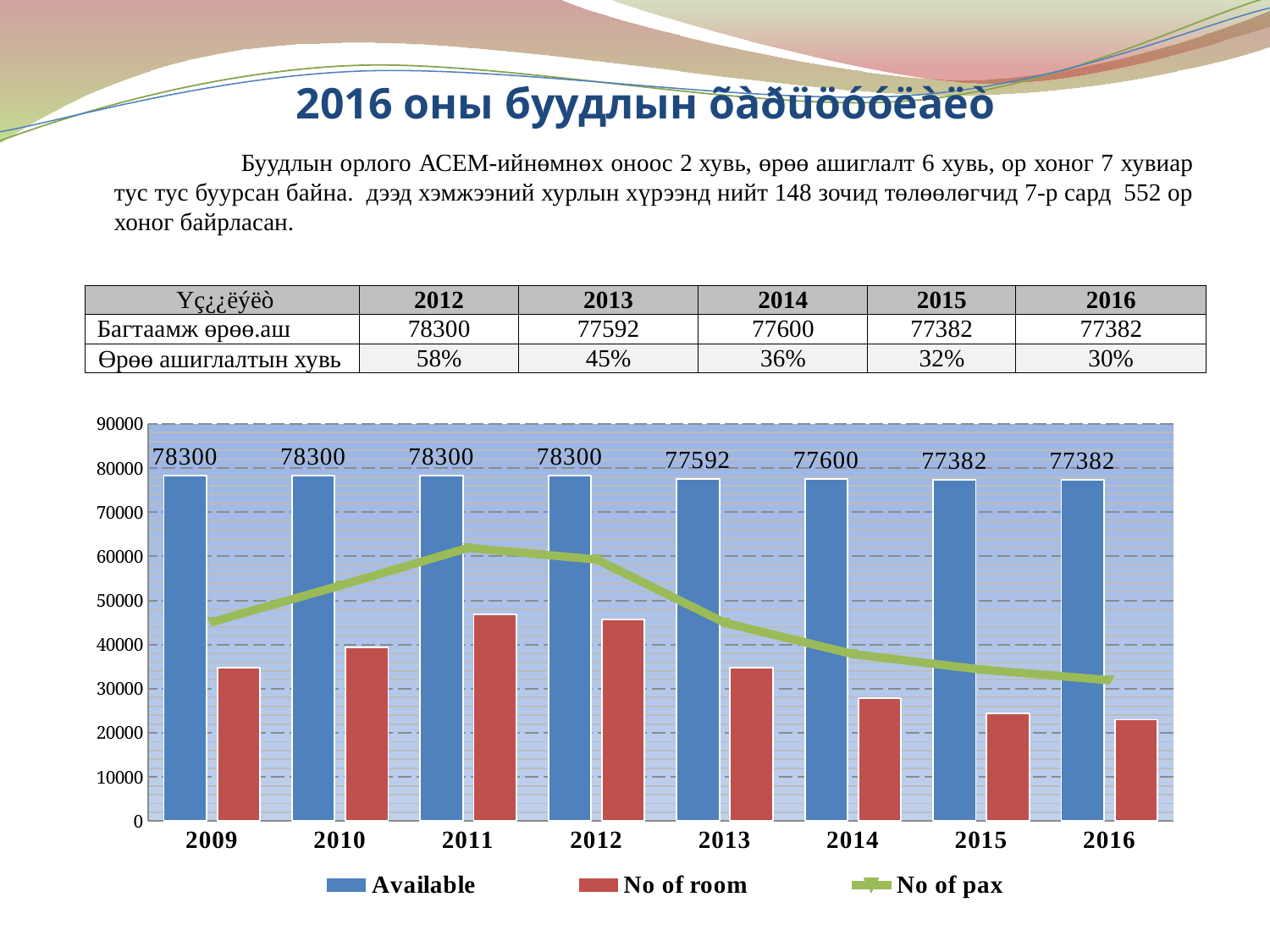
What is the value of the Available series for 2016? 77382 What kind of chart is shown on the slide? Bar and line chart Is the value of No of pax for 2009 greater or less than 50000? less Does the No of pax line rise or fall from 2011 to 2016? Falls What is the value of the Available series for 2013? 77592 How many series does the chart legend list? 3 How many years are shown on the x axis of the chart? 8 What is the difference between the Available values for 2009 and 2016? 918 What is the value of the Available series for 2009? 78300 Which year has the larger Available value, 2013 or 2014? 2014 Is the value of No of room for 2016 greater or less than 30000? less Is the value of No of room for 2011 greater or less than 40000? greater